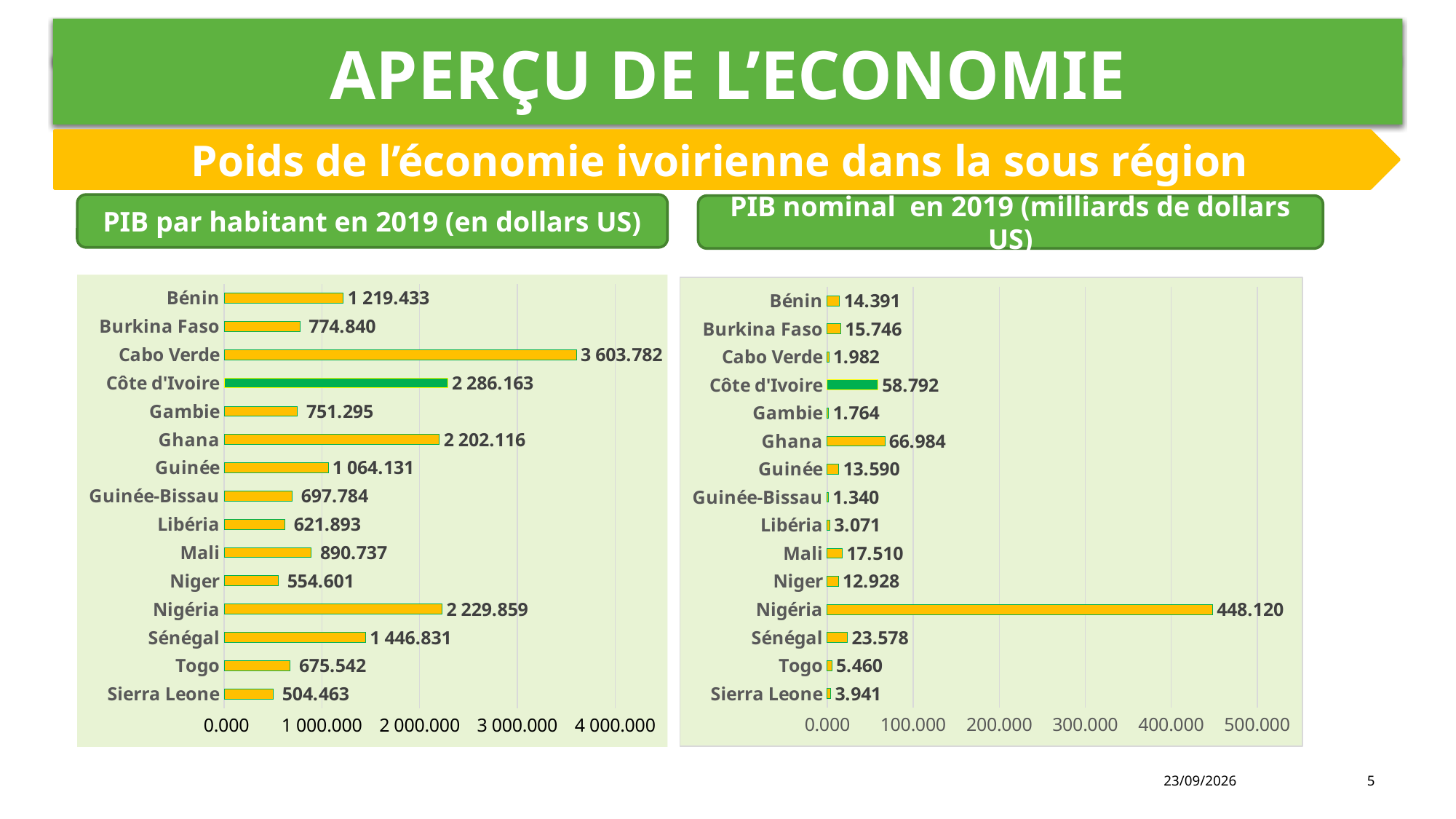
What kind of chart is the 'PIB nominal en 2019 (milliards de dollars US)' chart? Bar chart In the 'PIB par habitant en 2019 (en dollars US)' chart, which country's bar is coloured green instead of yellow? Côte d'Ivoire In the 'PIB nominal en 2019 (milliards de dollars US)' chart, what is the value for Sénégal? 23.578 In the 'PIB par habitant en 2019 (en dollars US)' chart, which country has the highest value? Cabo Verde In the 'PIB par habitant en 2019 (en dollars US)' chart, what is the difference between the values for Côte d'Ivoire and Nigéria? 56.304 In the 'PIB nominal en 2019 (milliards de dollars US)' chart, what is the difference between the values for Ghana and Côte d'Ivoire? 8.192 In the 'PIB nominal en 2019 (milliards de dollars US)' chart, which is larger, the value for Ghana or the value for Côte d'Ivoire? Ghana In the 'PIB nominal en 2019 (milliards de dollars US)' chart, what is the value for Nigéria? 448.120 In the 'PIB par habitant en 2019 (en dollars US)' chart, which country has the lowest value? Sierra Leone In the 'PIB par habitant en 2019 (en dollars US)' chart, what is the value for Côte d'Ivoire? 2 286.163 In the 'PIB par habitant en 2019 (en dollars US)' chart, how many countries are shown? 15 In the 'PIB nominal en 2019 (milliards de dollars US)' chart, which country has the lowest value? Guinée-Bissau